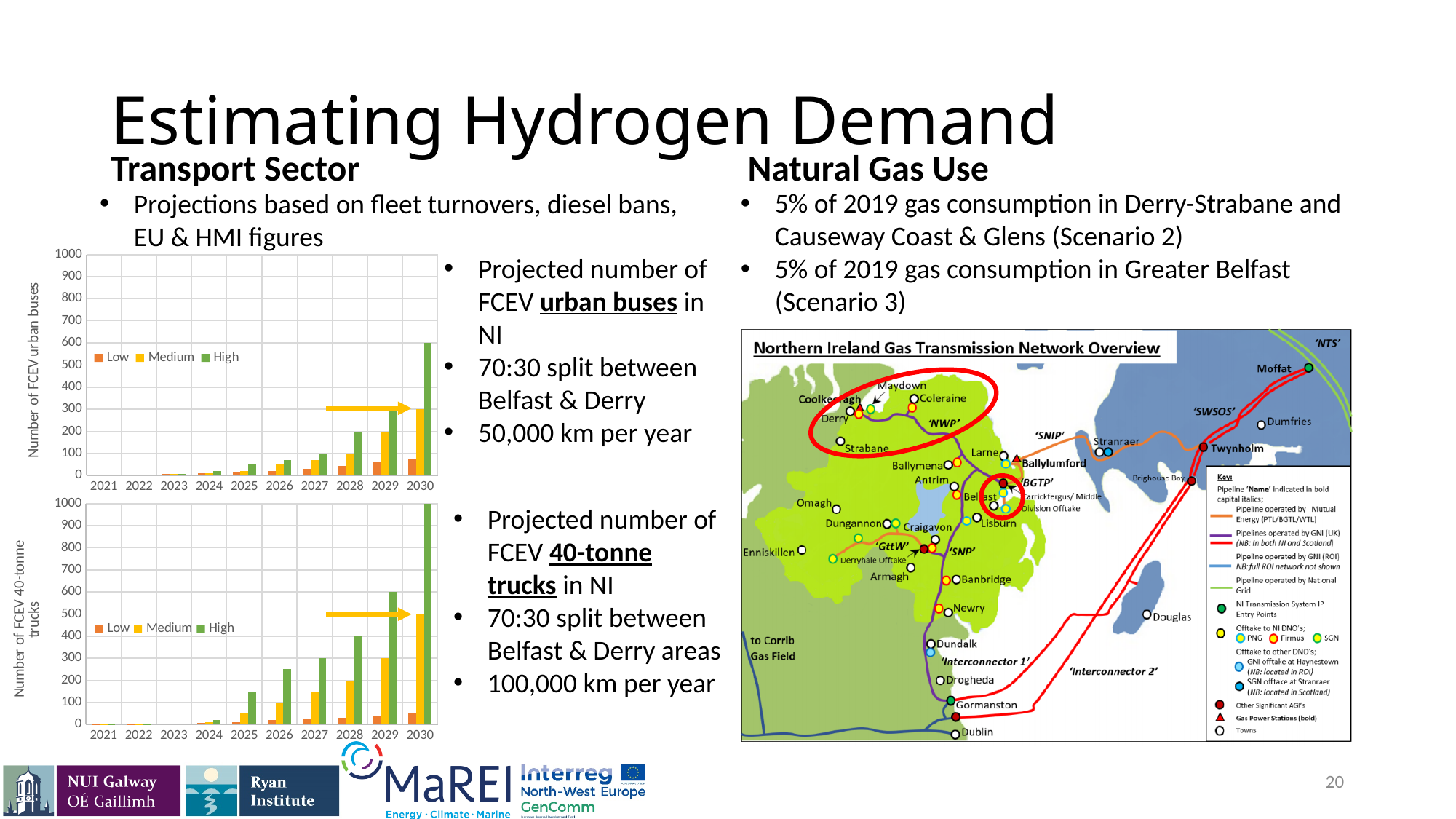
In the bottom chart (FCEV 40-tonne trucks), what is the High-scenario value for 2030? 1000 In the bottom chart (FCEV 40-tonne trucks), which is larger in 2030: the Medium-scenario value or the Low-scenario value? Medium In the top chart (FCEV urban buses), is the Medium-scenario value for 2028 greater or less than 200? less What is the y-axis label of the bottom chart? Number of FCEV 40-tonne trucks In the top chart (FCEV urban buses), which year has the highest High-scenario value? 2030 What are the legend entries in the bottom chart (FCEV 40-tonne trucks)? Low, Medium, High How many series does the legend of the top chart (FCEV urban buses) list? 3 How many years are shown on the x axis of the bottom chart (FCEV 40-tonne trucks)? 10 In the top chart (FCEV urban buses), what is the High-scenario value for 2030? 600 In the bottom chart (FCEV 40-tonne trucks), is the High-scenario value for 2029 greater or less than 500? greater In the top chart (FCEV urban buses), do the High-scenario values rise or fall from 2021 to 2030? rise What kind of chart is the top chart showing the number of FCEV urban buses? bar chart